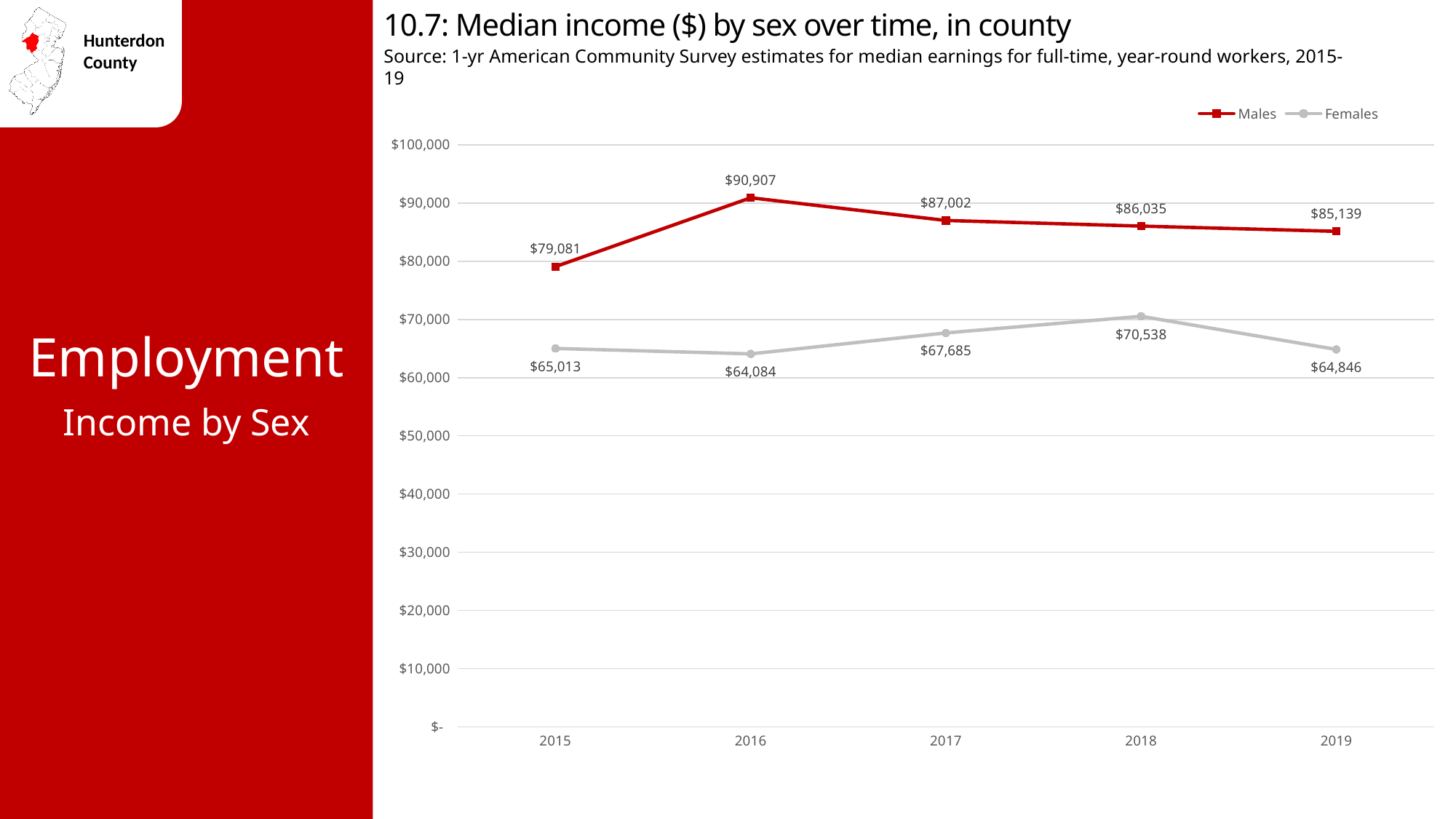
Is the median income for Females in 2018 greater or less than $70,000? greater Which was larger in 2017, the median income for Males or for Females? Males What was the median income for Males in 2015? $79,081 What is the difference between the Males and Females median income in 2019? $20,293 In which year was the median income for Females lowest? 2016 How many years are shown on the x axis? 5 What kind of chart is shown on the slide? Line chart How many series does the legend list? 2 What was the median income for Females in 2018? $70,538 What was the median income for Males in 2016? $90,907 Did the median income for Males rise or fall from 2016 to 2019? Fall In which year was the median income for Males highest? 2016